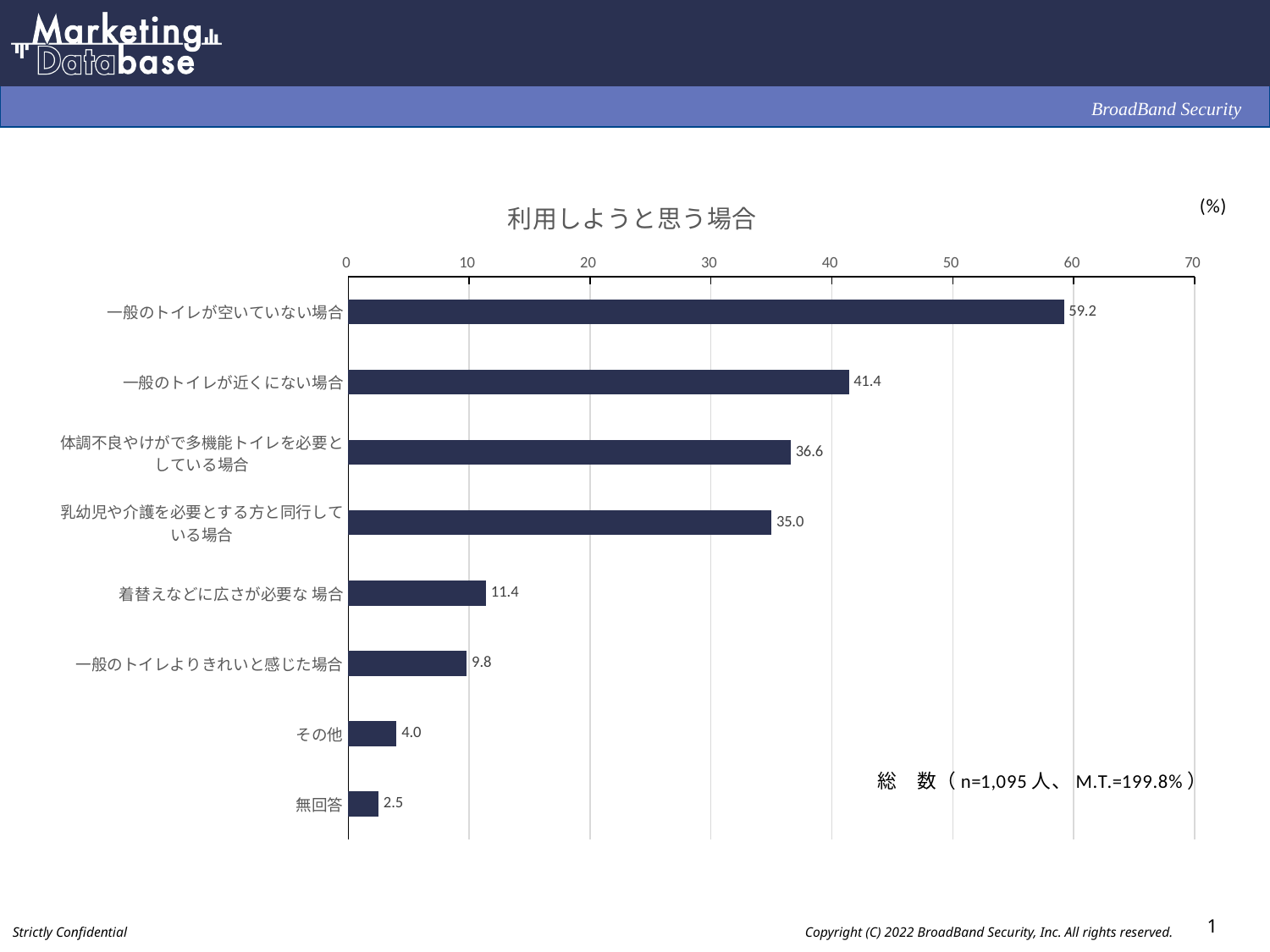
What is the value for 無回答? 2.5 What kind of chart is shown on the slide? bar chart Which is larger, the value for 体調不良やけがで多機能トイレを必要としている場合 or 乳幼児や介護を必要とする方と同行している場合? 体調不良やけがで多機能トイレを必要としている場合 What is the value for 着替えなどに広さが必要な 場合? 11.4 What is the title of the chart? 利用しようと思う場合 How many categories are shown in the chart? 8 Is the value for 一般のトイレよりきれいと感じた場合 greater or less than 10? less Which category has the highest value? 一般のトイレが空いていない場合 What is the value for 一般のトイレが近くにない場合? 41.4 Which category has the lowest value? 無回答 What is the value for 一般のトイレが空いていない場合? 59.2 What is the difference between the values for 一般のトイレが空いていない場合 and 一般のトイレが近くにない場合? 17.8